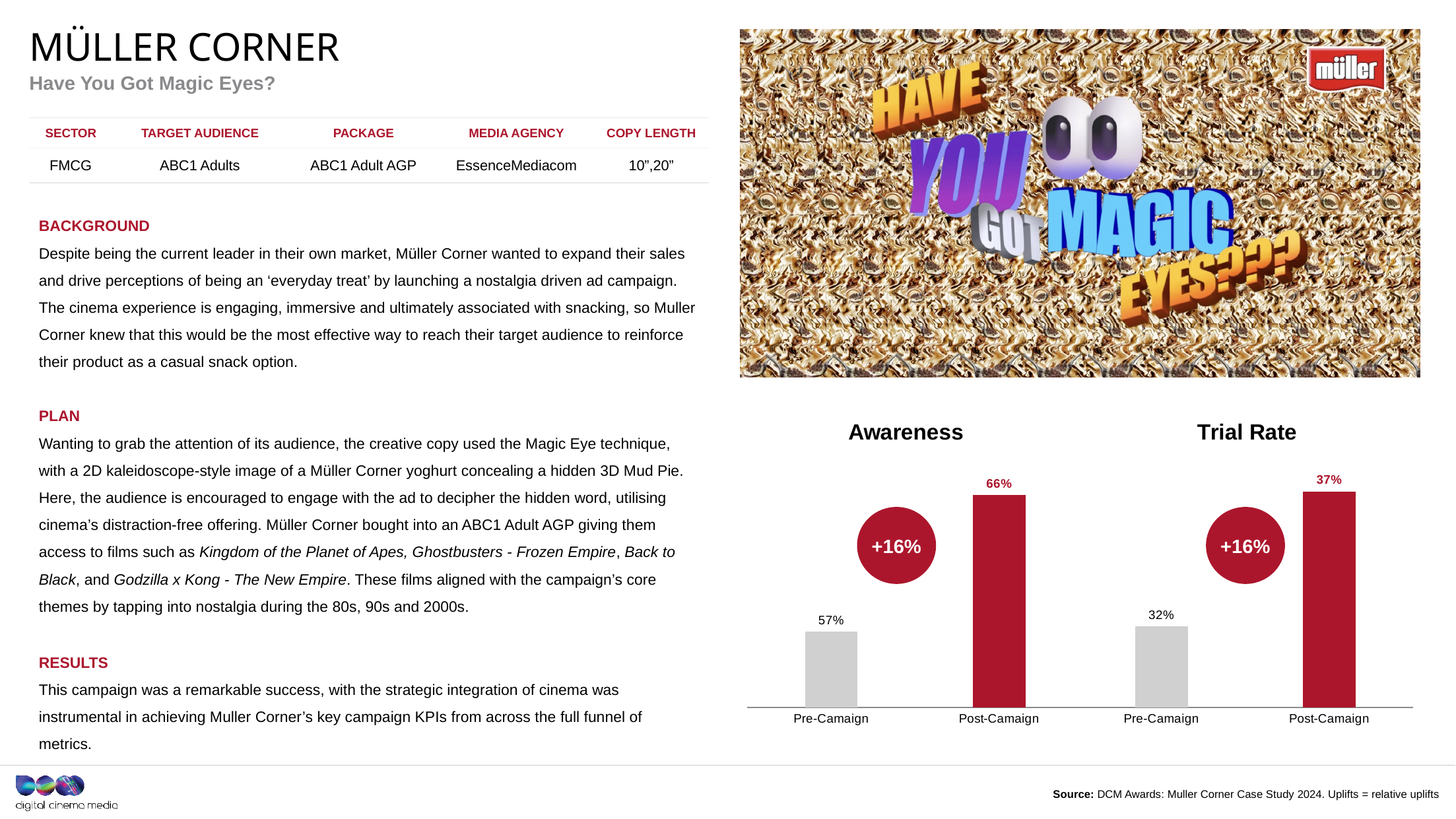
In the Trial Rate chart, do the values rise or fall from Pre-Camaign to Post-Camaign? Rise In the Awareness chart, what is the value for Pre-Camaign? 57% What kind of chart is the Awareness chart? Bar chart In the Awareness chart, what relative uplift is shown in the circle between the bars? +16% How many bars are in the Trial Rate chart? 2 In the Awareness chart, which bar is higher, Pre-Camaign or Post-Camaign? Post-Camaign In the Trial Rate chart, what is the value for Pre-Camaign? 32% In the Awareness chart, what is the difference between the Post-Camaign and Pre-Camaign values? 9% In the Trial Rate chart, what is the difference between the Post-Camaign and Pre-Camaign values? 5% In the Trial Rate chart, which category has the lowest value? Pre-Camaign In the Trial Rate chart, what is the value for Post-Camaign? 37% In the Awareness chart, what is the value for Post-Camaign? 66%